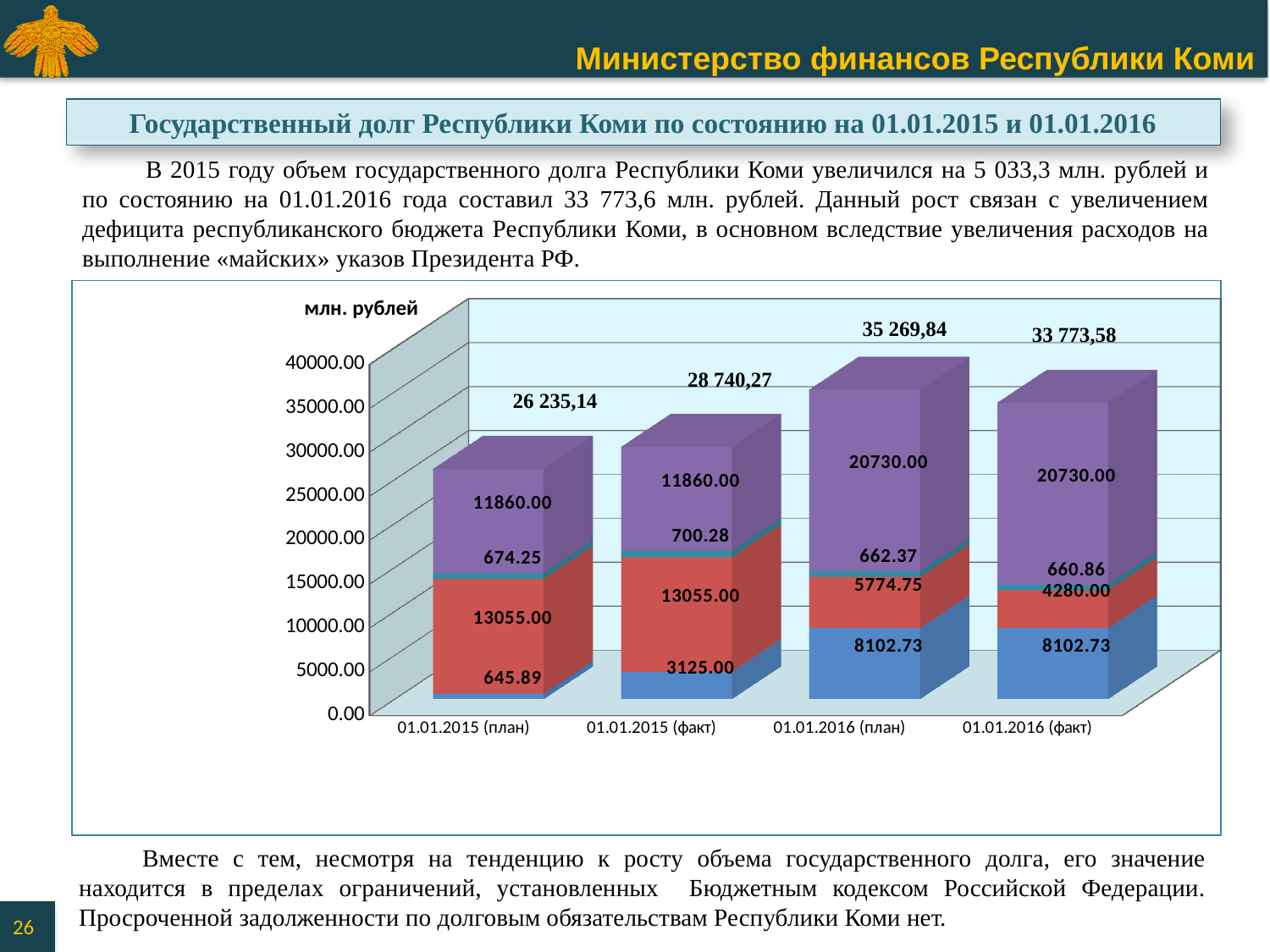
What kind of chart is shown on the slide? stacked bar chart Which category has the highest total value? 01.01.2016 (план) Is the total for 01.01.2015 (факт) greater or less than 30000? less What is the value of the purple (top) segment for 01.01.2016 (факт)? 20730.00 What is the difference between the total for 01.01.2016 (факт) and the total for 01.01.2015 (факт)? 5 033,31 Which category has the lowest total value? 01.01.2015 (план) What is the value of the blue (bottom) segment for 01.01.2015 (факт)? 3125.00 How many categories are shown on the x axis of the chart? 4 What unit label is printed at the top of the chart's vertical axis? млн. рублей Which has the larger red segment: 01.01.2016 (план) or 01.01.2016 (факт)? 01.01.2016 (план) What is the total value printed above the bar for 01.01.2016 (план)? 35 269,84 What is the total value printed above the bar for 01.01.2015 (план)? 26 235,14